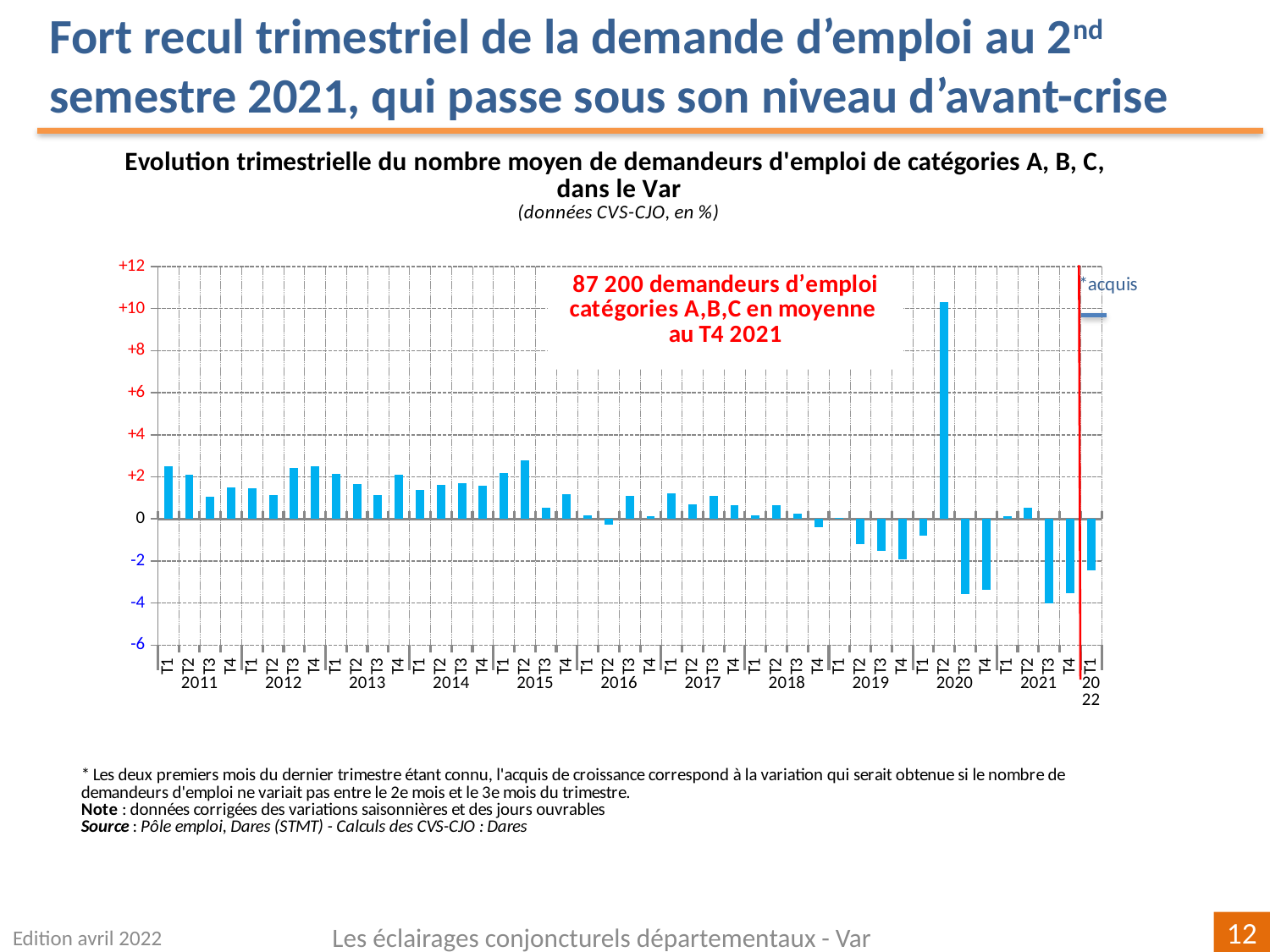
Is the value for T2 2015 greater or less than +2? greater Is the value for T1 2022 greater or less than 0? less Is the value for T2 2020 greater or less than +8? greater Which quarter has the lowest value in the chart? T3 2021 Which quarter has the highest value in the chart? T2 2020 How many years are labelled on the x axis of the chart? 12 What kind of chart is shown on the slide? bar chart Which is larger, the value for T2 2020 or the value for T2 2019? T2 2020 According to the annotation on the chart, how many demandeurs d'emploi of categories A, B, C were there on average in T4 2021? 87 200 From T2 2020 to T4 2020, do the values rise or fall? fall Which is larger, the value for T1 2011 or the value for T3 2011? T1 2011